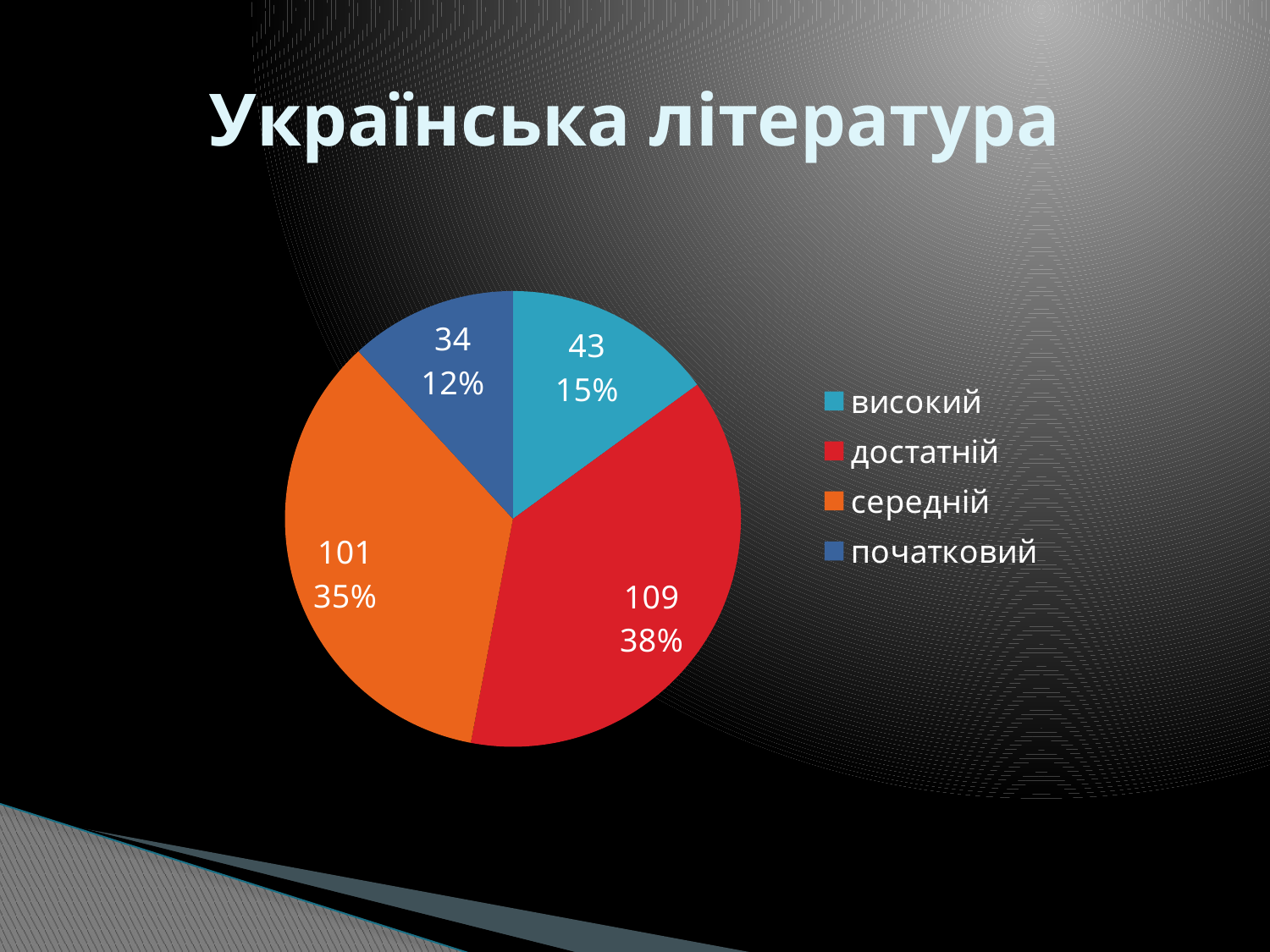
Which category has the largest slice? достатній What is the value for середній? 101 What share of the pie does середній take? 35% Which is larger, the value for високий or the value for початковий? високий What is the value for початковий? 34 Which category has the smallest slice? початковий How many categories does the pie chart have? 4 What kind of chart is shown on the slide? pie chart What is the value for достатній? 109 What is the value for високий? 43 What is the difference between the values for достатній and середній? 8 What share of the pie does початковий take? 12%